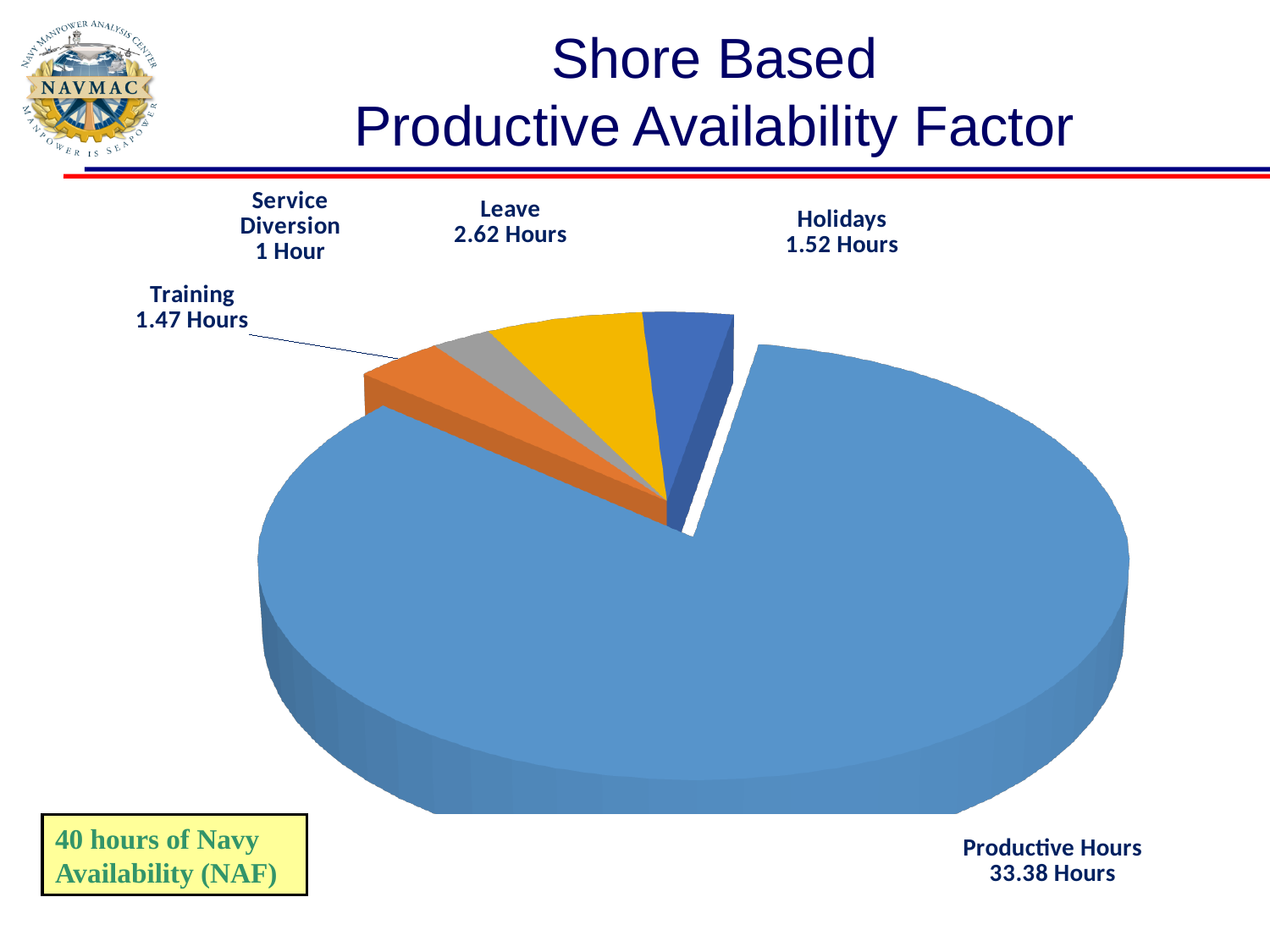
What is the difference in hours between Leave and Holidays? 1.10 Hours How many slices does the pie chart have? 5 What is the title of the slide containing the chart? Shore Based Productive Availability Factor How many hours are shown for Holidays? 1.52 Hours How many hours are shown for Leave? 2.62 Hours What type of chart is shown on the slide? Pie chart How many hours are shown for Training? 1.47 Hours How many hours are shown for Productive Hours? 33.38 Hours Which is larger, Leave or Holidays? Leave Which category has the smallest slice of the pie? Service Diversion Which category has the largest slice of the pie? Productive Hours How many hours are shown for Service Diversion? 1 Hour